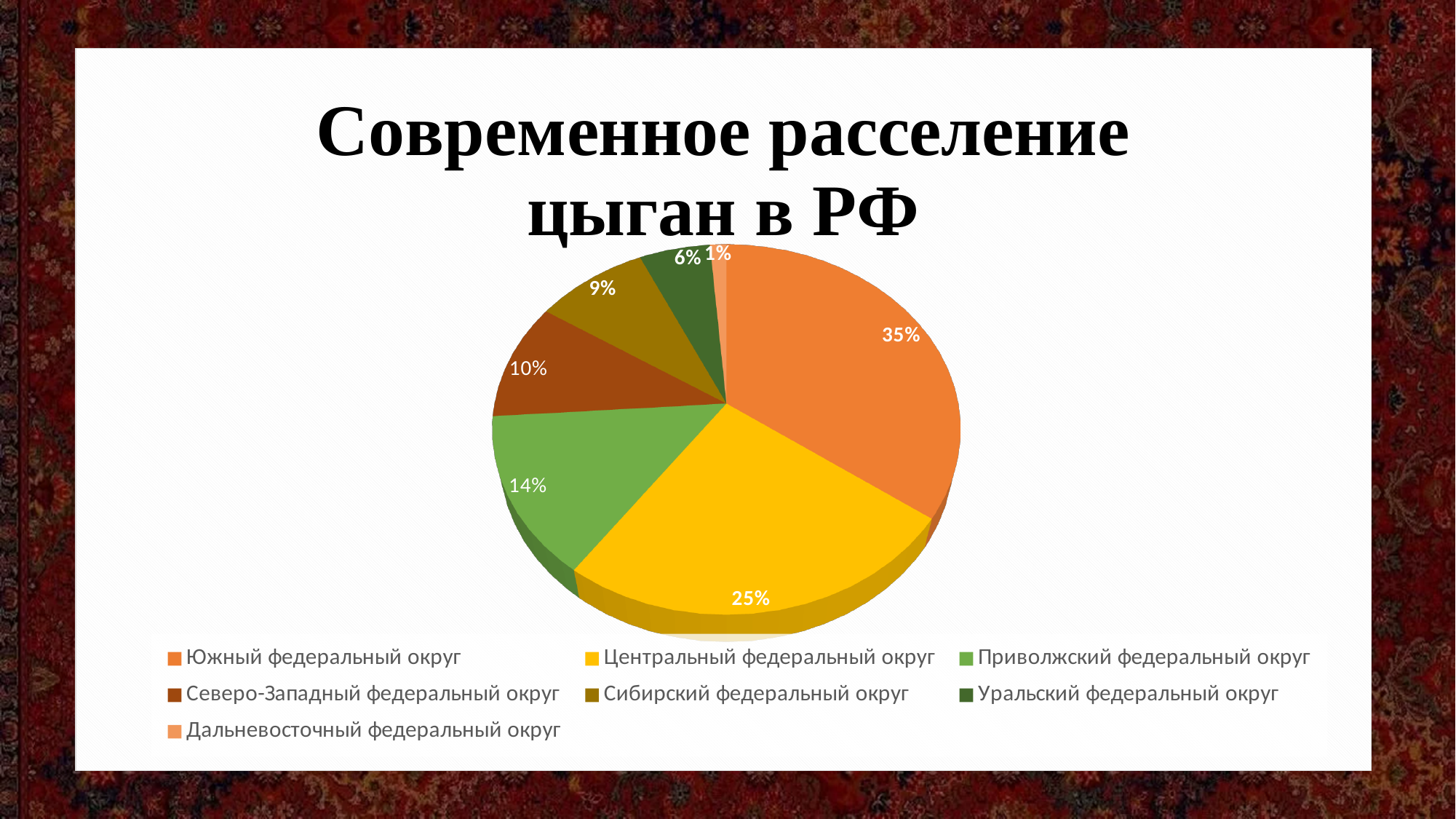
What share of the pie does Северо-Западный федеральный округ have? 10% What share of the pie does Приволжский федеральный округ have? 14% What share of the pie does Центральный федеральный округ have? 25% How many categories does the legend list? 7 Which is larger, the share for Приволжский федеральный округ or for Сибирский федеральный округ? Приволжский федеральный округ Which federal district has the largest slice of the pie? Южный федеральный округ Which federal district has the smallest slice of the pie? Дальневосточный федеральный округ What is the difference in percentage points between Южный федеральный округ and Центральный федеральный округ? 10%